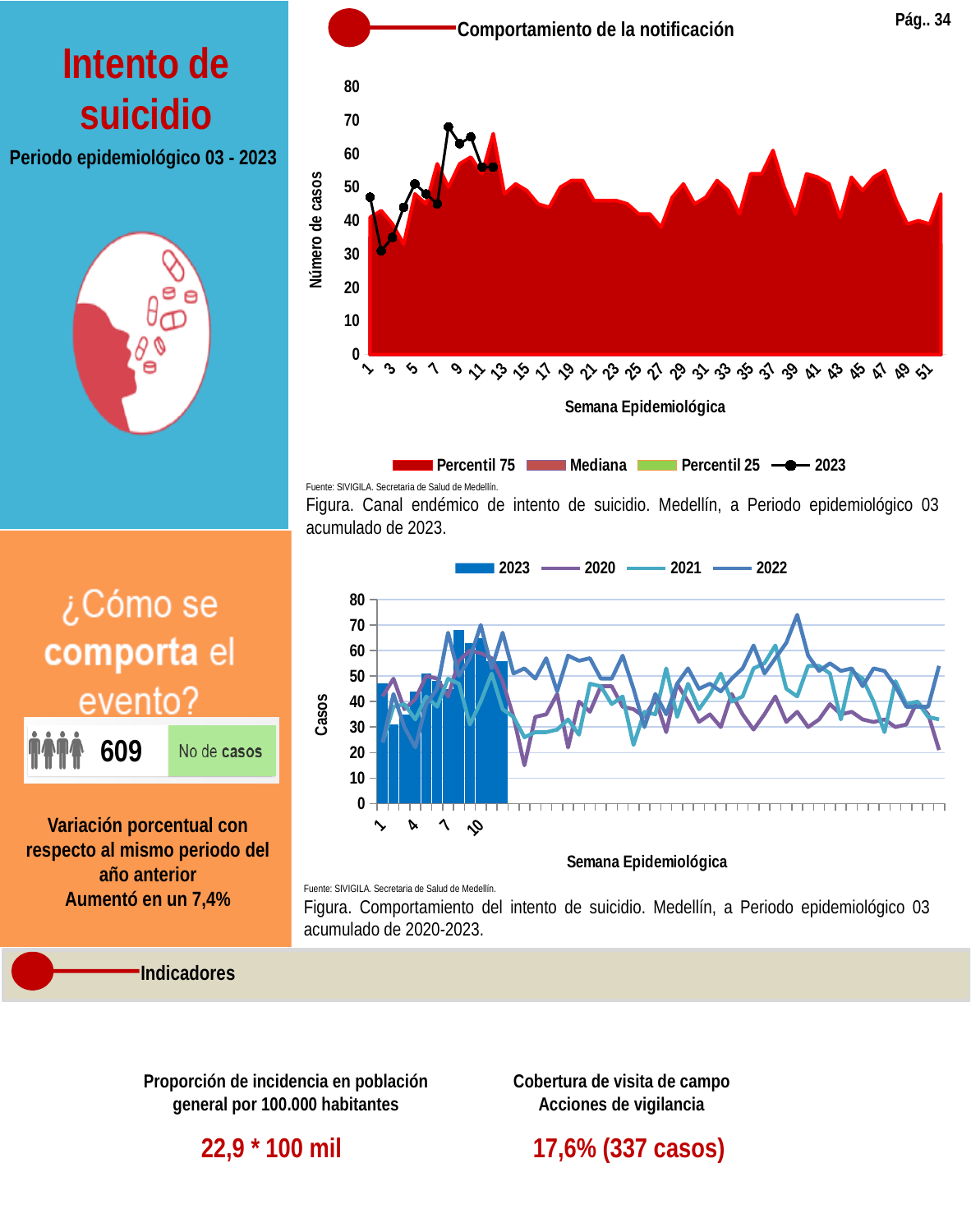
In the bottom chart (Comportamiento del intento de suicidio), is the 2023 value for week 2 greater or less than 40? less In the top chart (Canal endémico), which is larger for 2023: the value at week 8 or the value at week 2? week 8 In the top chart (Canal endémico), is the 2023 value for week 8 greater or less than 60? greater In the bottom chart (Comportamiento del intento de suicidio), is the highest 2022 value greater or less than 70? greater In the bottom chart (Comportamiento del intento de suicidio), which series is drawn as bars rather than a line? 2023 In the top chart (Canal endémico), how many points does the 2023 line have? 12 In the top chart (Canal endémico), does the 2023 line rise or fall from week 1 to week 2? fall In the bottom chart (Comportamiento del intento de suicidio), how many bars are plotted for 2023? 12 In the top chart (Canal endémico), how many series does the legend list? 4 In the bottom chart (Comportamiento del intento de suicidio), how many series does the legend list? 4 In the top chart (Canal endémico), what is the label of the vertical axis? Número de casos